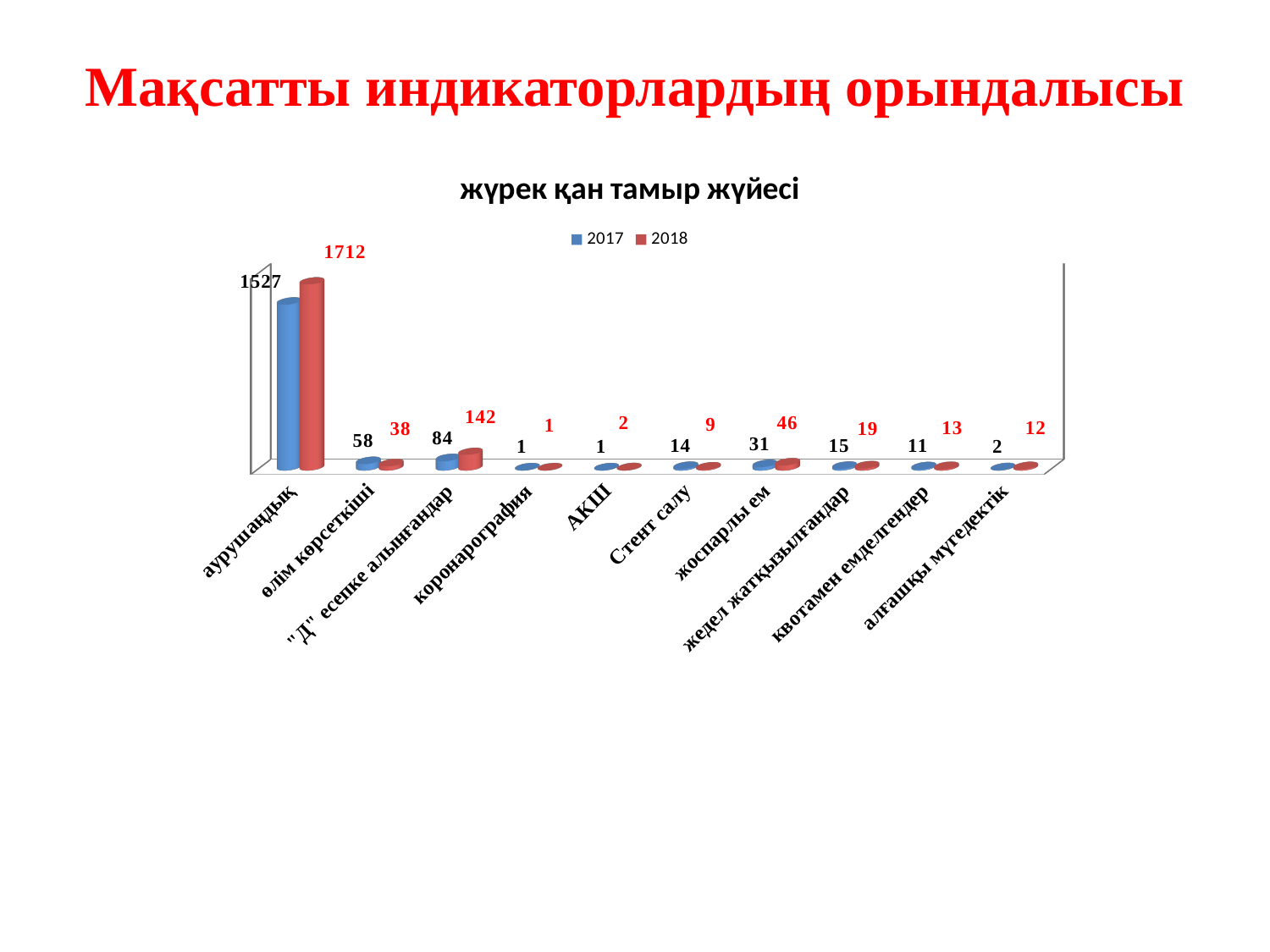
What is the 2018 value for аурушаңдық? 1712 What is the 2017 value for "Д" есепке алынғандар? 84 How many categories are shown on the x axis? 10 What is the 2018 value for жоспарлы ем? 46 What kind of chart is shown on the slide? bar chart Which is larger for алғашқы мүгедектік, the 2017 value or the 2018 value? 2018 What is the difference between the 2017 and 2018 values for өлім көрсеткіші? 20 What is the title of the chart? жүрек қан тамыр жүйесі How many series does the legend list? 2 What is the 2017 value for Стент салу? 14 What is the difference between the 2018 and 2017 values for аурушаңдық? 185 Which category has the highest 2017 value? аурушаңдық